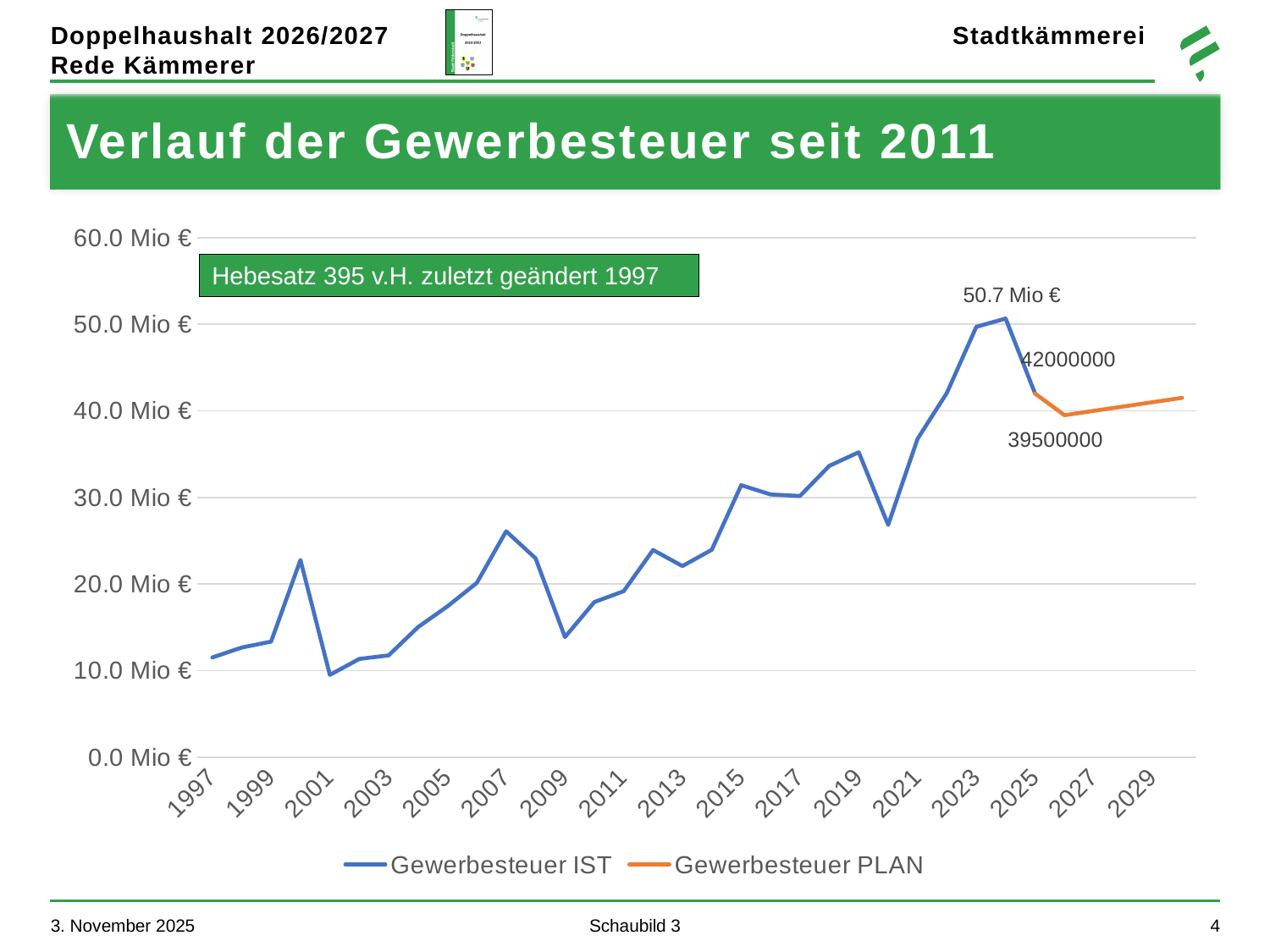
What kind of chart is shown on the slide? line chart What is the lowest value labelled on the Gewerbesteuer PLAN line? 39500000 Which year has the larger Gewerbesteuer IST value, 2007 or 2009? 2007 How many series does the legend list? 2 Is the Gewerbesteuer IST value for 2021 greater or less than 30.0 Mio €? greater How many year labels are shown on the x axis? 17 Does the Gewerbesteuer IST line generally rise or fall from 1997 to 2023? rise What text is shown in the green box inside the chart? Hebesatz 395 v.H. zuletzt geändert 1997 Is the Gewerbesteuer IST value for 2009 greater or less than 20.0 Mio €? less What are the two series named in the legend? Gewerbesteuer IST and Gewerbesteuer PLAN Is the Gewerbesteuer IST value for 1997 greater or less than 10.0 Mio €? greater What is the highest value labelled on the Gewerbesteuer IST line? 50.7 Mio €